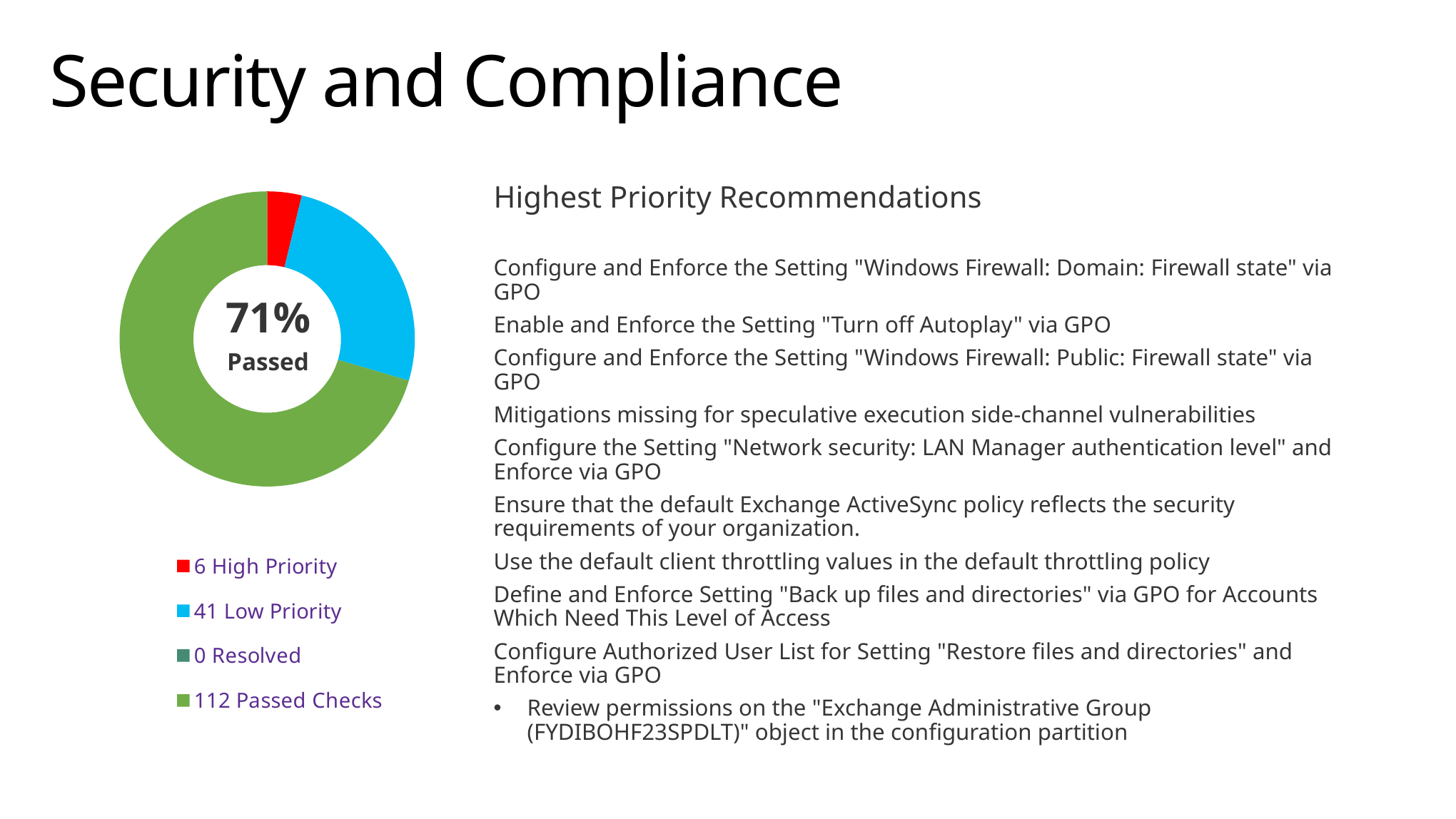
What percentage is shown in the centre of the donut chart as Passed? 71% Which category in the chart has the largest count? Passed Checks How many checks are labelled High Priority in the chart legend? 6 What is the difference between the number of Passed Checks and Low Priority checks? 71 How many checks are labelled Resolved in the chart legend? 0 What is the difference between the number of Low Priority and High Priority checks? 35 What colour is the High Priority slice of the chart? Red Which category in the chart has the smallest count? Resolved Which is larger, the number of High Priority checks or the number of Low Priority checks? Low Priority How many Passed Checks does the chart legend show? 112 How many checks are labelled Low Priority in the chart legend? 41 How many categories are listed in the chart legend? 4